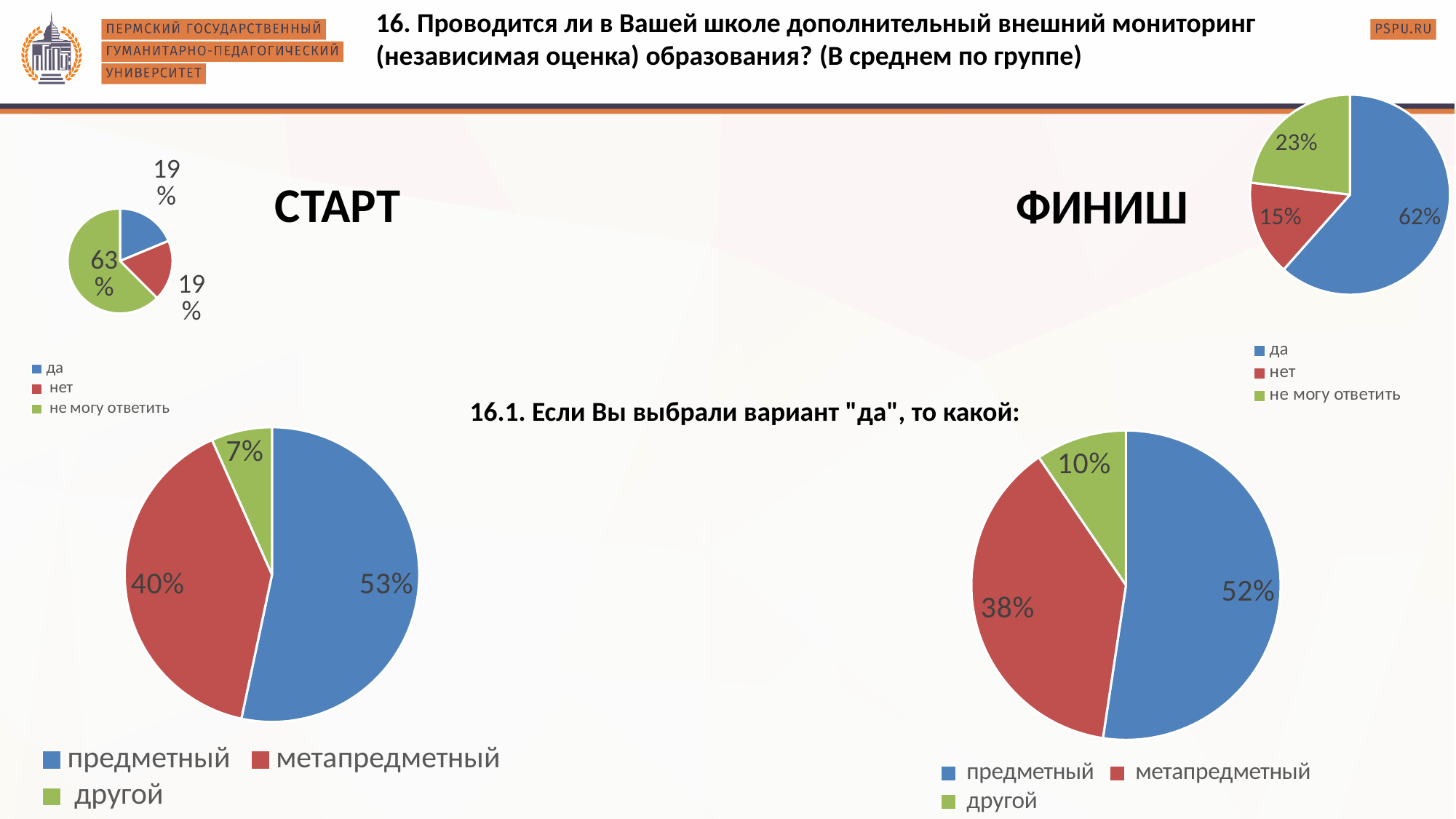
In the bottom-left pie chart (СТАРТ, question 16.1), which category has the smallest slice? другой In the top-right pie chart (ФИНИШ, question 16), what is the difference between the "да" share and the "не могу ответить" share? 39% In the bottom-right pie chart (ФИНИШ, question 16.1), which category has the largest slice? предметный In the top-right pie chart (ФИНИШ, question 16), what share is labelled for "да"? 62% How many slices does the bottom-left pie chart (СТАРТ, question 16.1) have? 3 In the top-left pie chart (СТАРТ, question 16), what share is labelled for "не могу ответить"? 63% In the bottom-left pie chart (СТАРТ, question 16.1), what share is labelled for "метапредметный"? 40% In the bottom-right pie chart (ФИНИШ, question 16.1), what share is labelled for "другой"? 10% How many entries does the legend of the bottom-right pie chart (ФИНИШ, question 16.1) list? 3 What type of chart is used in the top-right (ФИНИШ, question 16)? pie chart In the top-right pie chart (ФИНИШ, question 16), what share is labelled for "нет"? 15% Which is larger: the "предметный" share in the bottom-left chart (СТАРТ) or the "предметный" share in the bottom-right chart (ФИНИШ)? bottom-left (СТАРТ), 53%